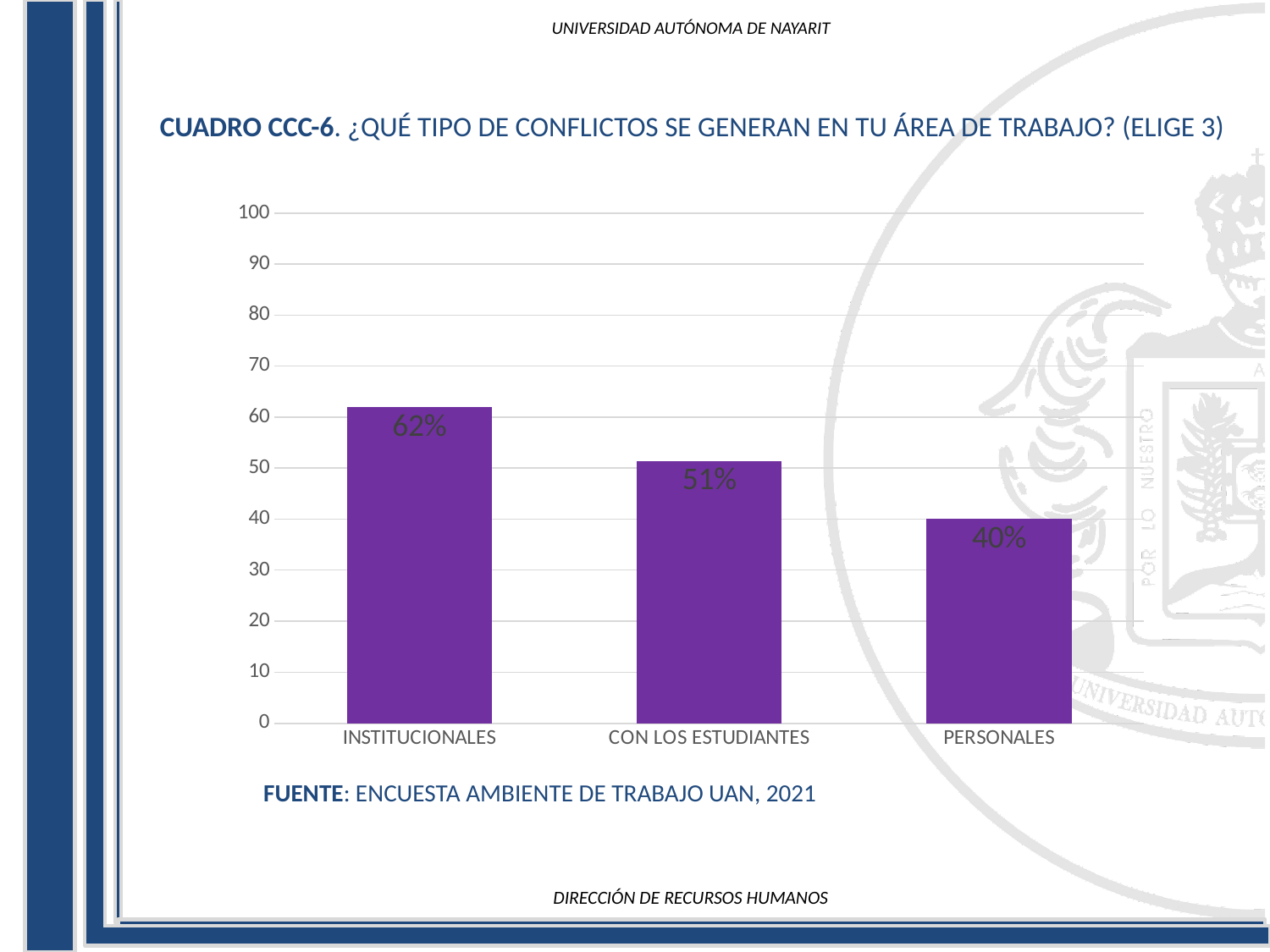
Which is larger, the value for CON LOS ESTUDIANTES or the value for PERSONALES? CON LOS ESTUDIANTES What is the value for INSTITUCIONALES? 62% How many categories are shown in the chart? 3 What is the difference between the values for CON LOS ESTUDIANTES and PERSONALES? 11% Which category has the lowest value? PERSONALES What is the difference between the values for INSTITUCIONALES and PERSONALES? 22% What is the value for CON LOS ESTUDIANTES? 51% Which category has the highest value? INSTITUCIONALES What is the value for PERSONALES? 40% Do the values rise or fall from left to right along the x axis? fall What kind of chart is shown on the slide? bar chart Is the value for INSTITUCIONALES greater or less than 50? greater